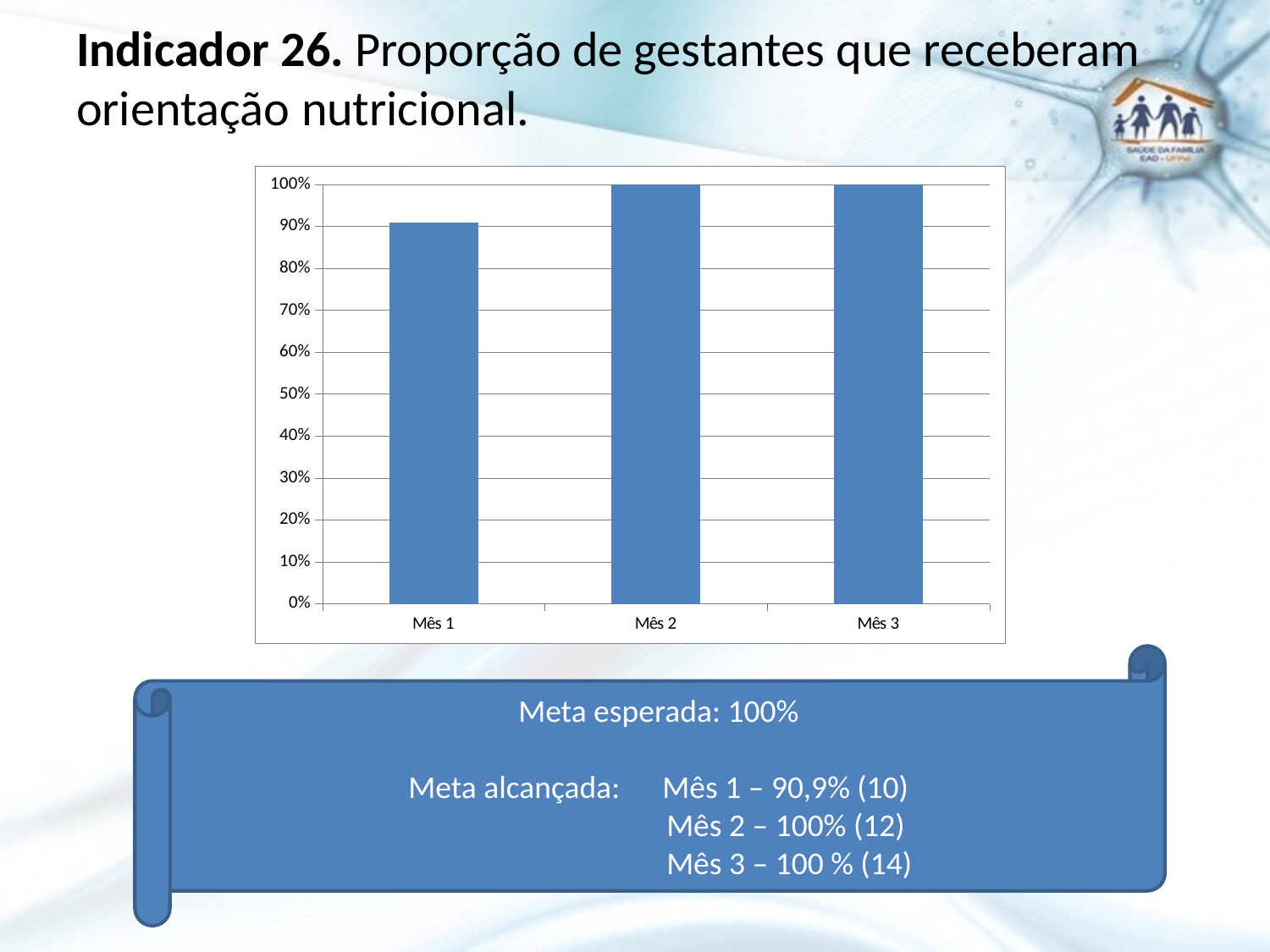
What is the highest tick shown on the vertical axis of the chart? 100% What is the value for Mês 3? 100% What is the difference between the value for Mês 2 and the value for Mês 1? 9,1% Which is larger, the value for Mês 1 or the value for Mês 2? Mês 2 What is the value for Mês 1? 90,9% How many months (categories) are plotted in the chart? 3 What kind of chart is shown on the slide? bar chart What is the value for Mês 2? 100% Is the value for Mês 1 greater or less than 80%? greater Which month has the lowest value in the chart? Mês 1 Do the values rise or fall from Mês 1 to Mês 2? rise Is the value for Mês 1 greater or less than 100%? less